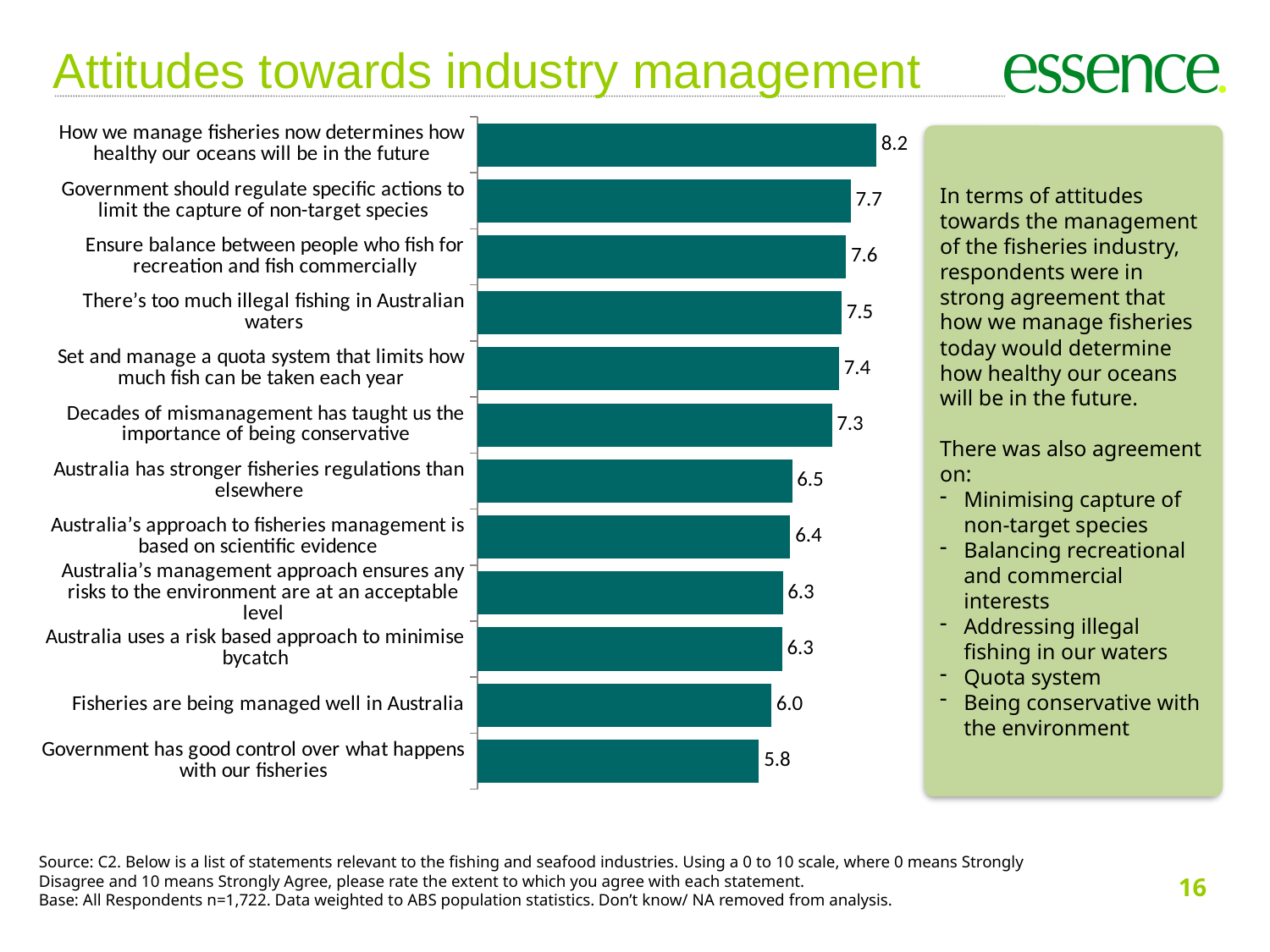
What is the value for "There's too much illegal fishing in Australian waters"? 7.5 What is the value for "Fisheries are being managed well in Australia"? 6.0 Do the values rise or fall from the top bar to the bottom bar? Fall Which statement has the highest value? How we manage fisheries now determines how healthy our oceans will be in the future What is the title of the slide containing the chart? Attitudes towards industry management How many statements are plotted in the chart? 12 What kind of chart is shown on the slide? Bar chart Which statement has the lowest value? Government has good control over what happens with our fisheries What is the value for "How we manage fisheries now determines how healthy our oceans will be in the future"? 8.2 Which is larger: the value for "Decades of mismanagement has taught us the importance of being conservative" or "Australia's approach to fisheries management is based on scientific evidence"? Decades of mismanagement has taught us the importance of being conservative What is the difference between "Government should regulate specific actions to limit the capture of non-target species" and "Australia has stronger fisheries regulations than elsewhere"? 1.2 What is the difference between the highest value (8.2) and the lowest value (5.8)? 2.4